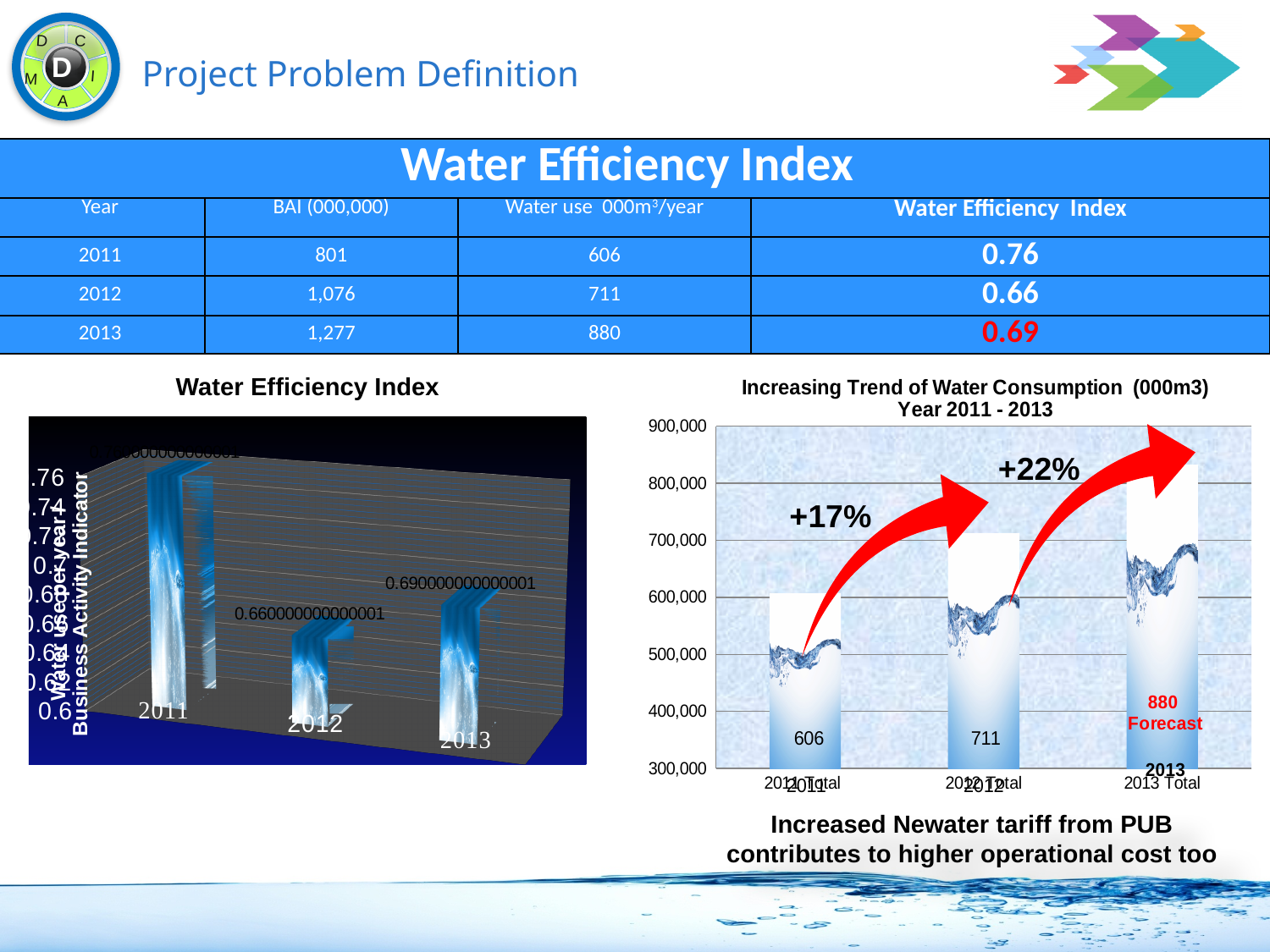
In the 'Increasing Trend of Water Consumption' chart, what is the difference between the 2012 label (711) and the 2011 label (606)? 105 In the 'Increasing Trend of Water Consumption' chart, what is the data label on the 2011 bar? 606 In the 'Water Efficiency Index' chart on the left, which year has the lowest bar? 2012 In the 'Increasing Trend of Water Consumption' chart, which year has the highest bar? 2013 In the 'Increasing Trend of Water Consumption' chart, do the bars rise or fall from 2011 to 2013? rise In the 'Increasing Trend of Water Consumption' chart, which year has the lowest bar? 2011 In the 'Increasing Trend of Water Consumption' chart, how many bars are plotted? 3 In the 'Increasing Trend of Water Consumption' chart, is the 2013 bar greater or less than 800,000 on the axis? greater In the 'Increasing Trend of Water Consumption' chart, what percentage increase is annotated between 2011 and 2012? +17% What kind of chart is the 'Water Efficiency Index' chart on the left? bar chart In the 'Increasing Trend of Water Consumption' chart, what is the forecast value labelled on the 2013 bar? 880 In the 'Increasing Trend of Water Consumption' chart, what is the data label on the 2012 bar? 711